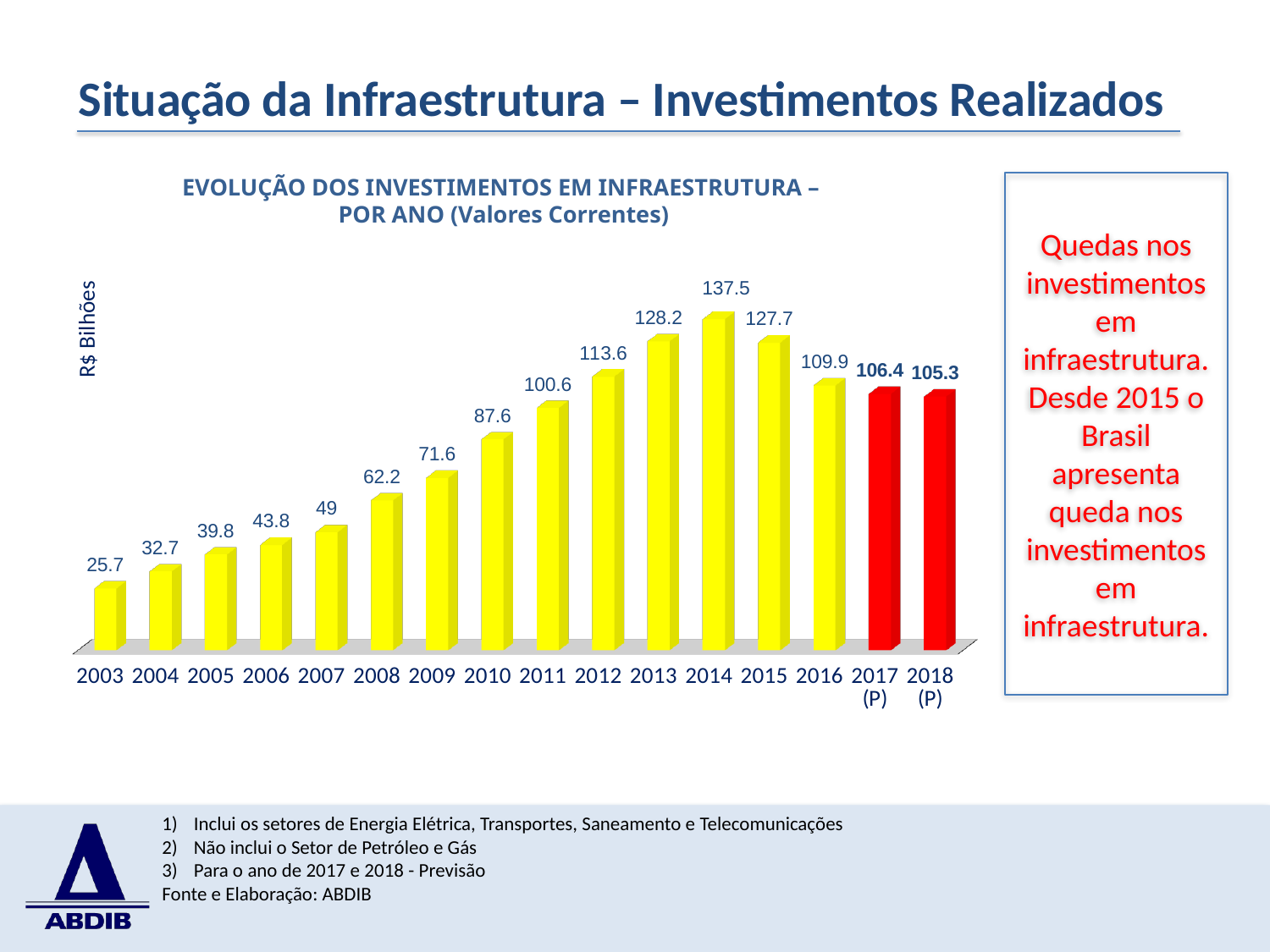
How many years are shown on the x axis? 16 What is the difference between the values for 2014 and 2016? 27.6 Do the values rise or fall from 2003 to 2014? rise What is the value for 2014? 137.5 What is the value for 2017 (P)? 106.4 Which is larger, the value for 2012 or the value for 2015? 2015 Which year has the lowest value? 2003 What kind of chart is this? bar chart What unit is shown on the vertical axis label? R$ Bilhões What colour are the bars for 2017 (P) and 2018 (P)? red Which year has the highest value? 2014 What is the value for 2003? 25.7